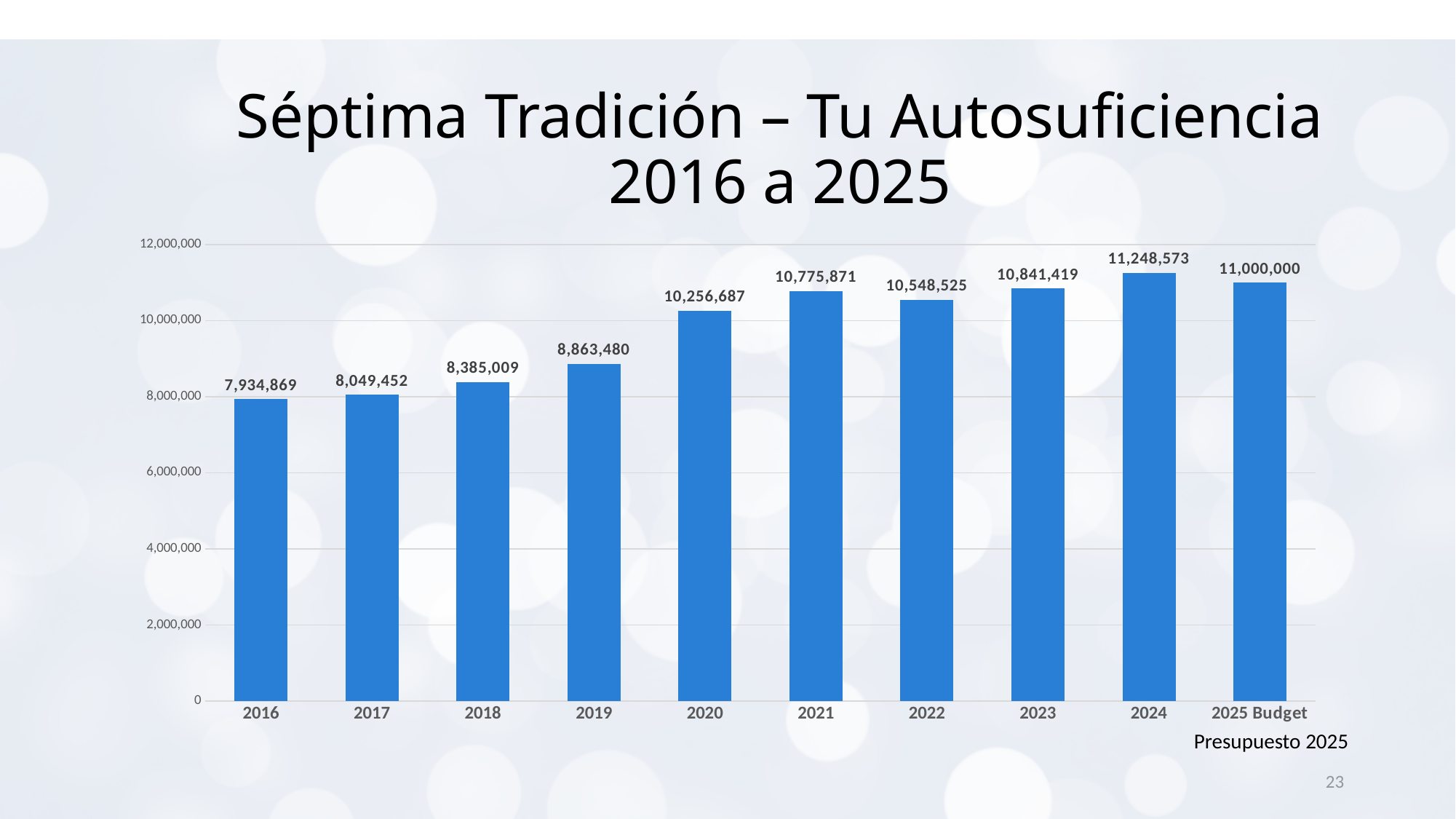
Which year has the lowest value? 2016 What is the difference between the 2024 value and the 2016 value? 3,313,704 Is the value for 2019 greater or less than 10,000,000? less How many bars are shown in the chart? 10 What is the difference between the 2024 value and the 2025 Budget value? 248,573 What kind of chart is shown on the slide? bar chart What is the title of the slide? Séptima Tradición – Tu Autosuficiencia 2016 a 2025 What is the value shown for 2025 Budget? 11,000,000 Which is larger, the value for 2021 or the value for 2022? 2021 What is the value shown for 2020? 10,256,687 Which year has the highest value? 2024 What is the value shown for 2016? 7,934,869